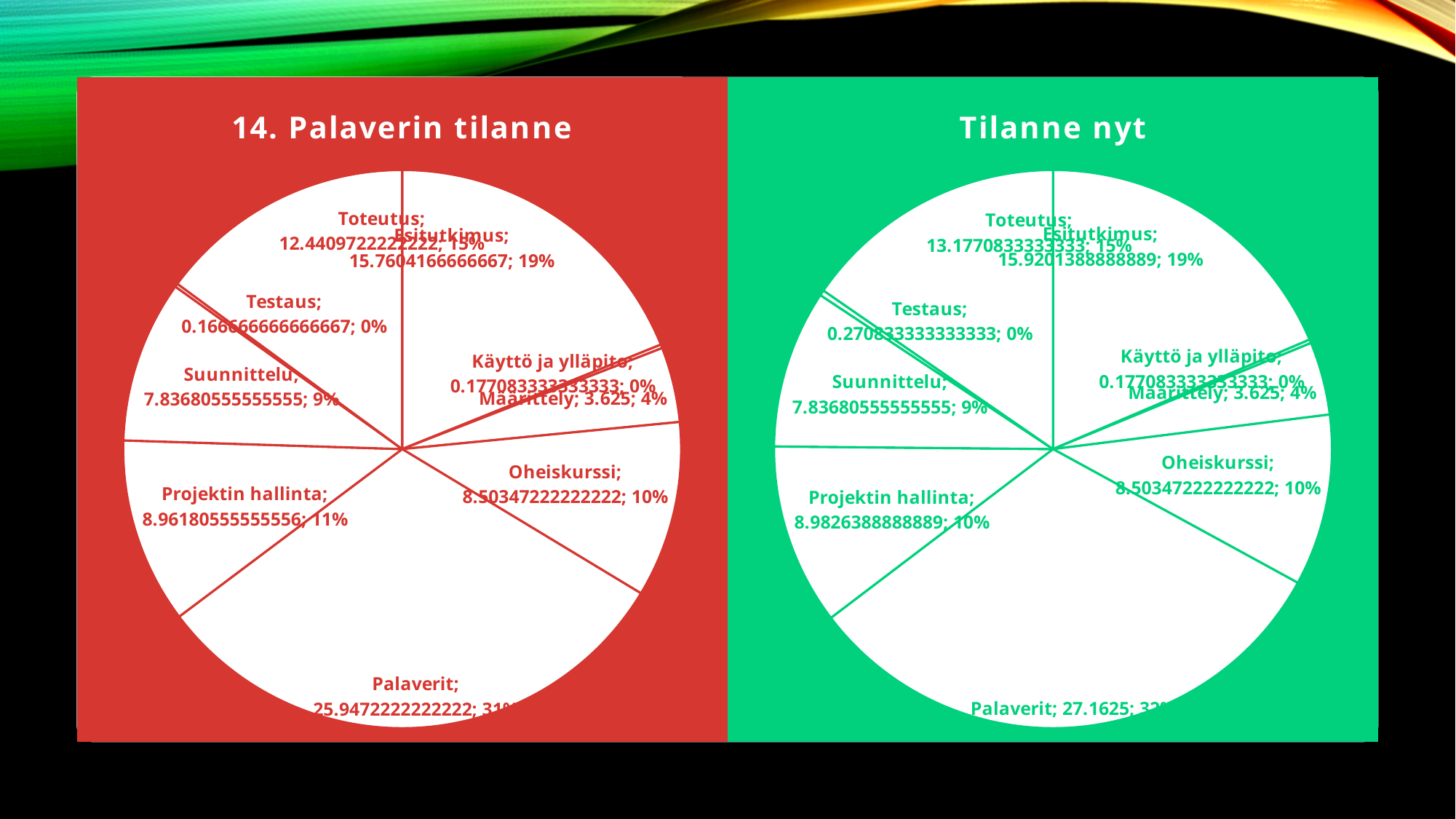
In the "14. Palaverin tilanne" chart, what is the value for Projektin hallinta? 8.96180555555556 What kind of chart is shown under the title "14. Palaverin tilanne"? Pie chart In the "Tilanne nyt" chart, which is larger, Projektin hallinta or Määrittely? Projektin hallinta In the "Tilanne nyt" chart, what is the value for Palaverit? 27.1625 In the "Tilanne nyt" chart, how many categories are shown? 9 In the "14. Palaverin tilanne" chart, what share of the pie does Suunnittelu represent? 9% In the "14. Palaverin tilanne" chart, which category has the largest slice? Palaverit In the "14. Palaverin tilanne" chart, what is the value for Oheiskurssi? 8.50347222222222 In the "Tilanne nyt" chart, what share of the pie does Oheiskurssi represent? 10% In the "Tilanne nyt" chart, what is the value for Testaus? 0.270833333333333 What is the title of the chart on the right side of the slide? Tilanne nyt In the "14. Palaverin tilanne" chart, what is the value for Suunnittelu? 7.83680555555555